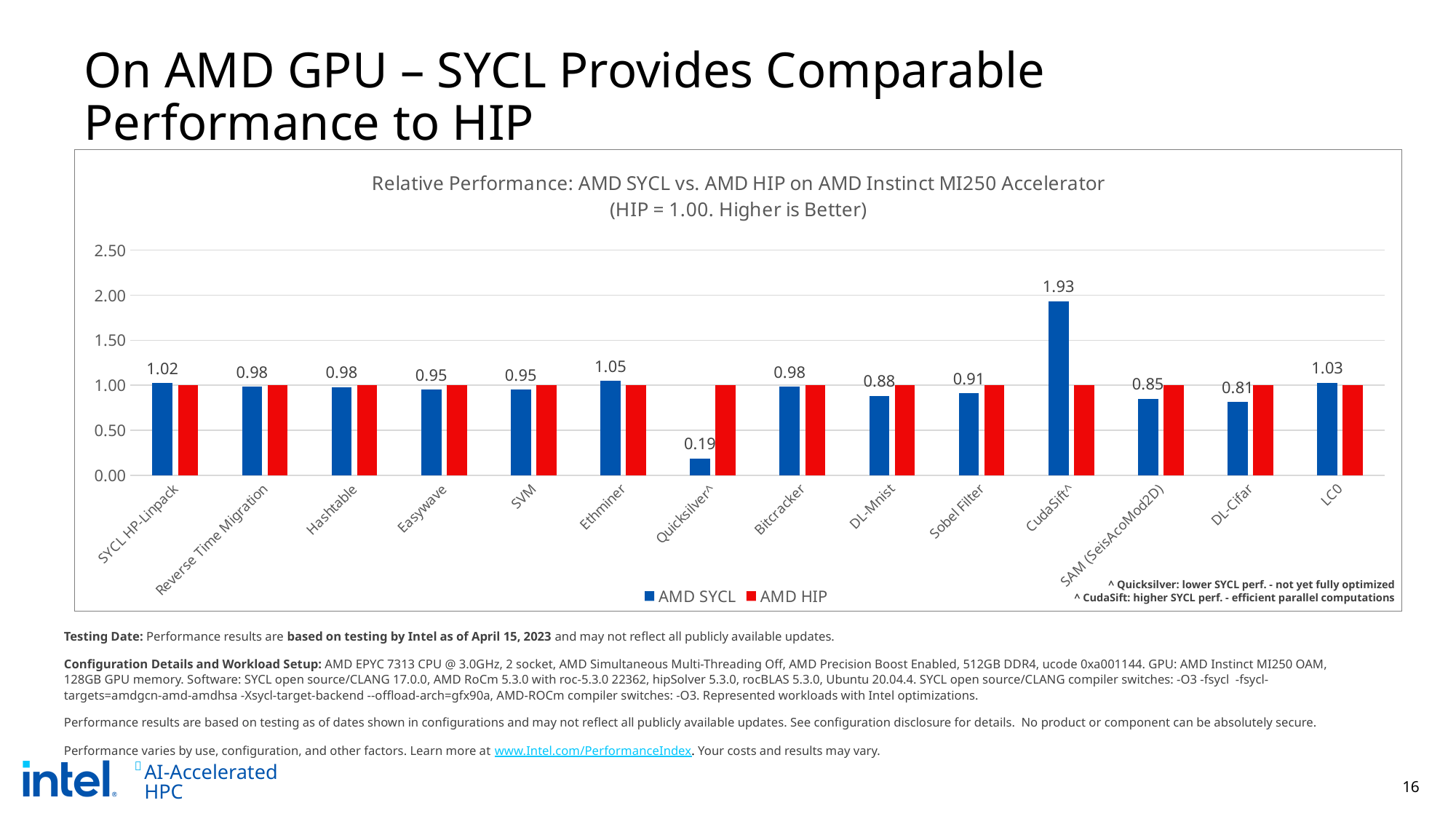
What is the AMD SYCL relative performance value for CudaSift? 1.93 What kind of chart is shown on the slide? Bar chart How many workloads are shown on the x axis of the chart? 14 How many series does the chart legend list? 2 What is the difference between the AMD SYCL values for CudaSift and Quicksilver? 1.74 Is the AMD SYCL value for CudaSift greater or less than 1.50? greater What is the AMD SYCL relative performance value for Ethminer? 1.05 Which workload has the highest AMD SYCL relative performance? CudaSift Which workload has the lowest AMD SYCL relative performance? Quicksilver Which has a larger AMD SYCL value, DL-Mnist or Sobel Filter? Sobel Filter What is the AMD SYCL relative performance value for Quicksilver? 0.19 What is the AMD SYCL relative performance value for DL-Cifar? 0.81